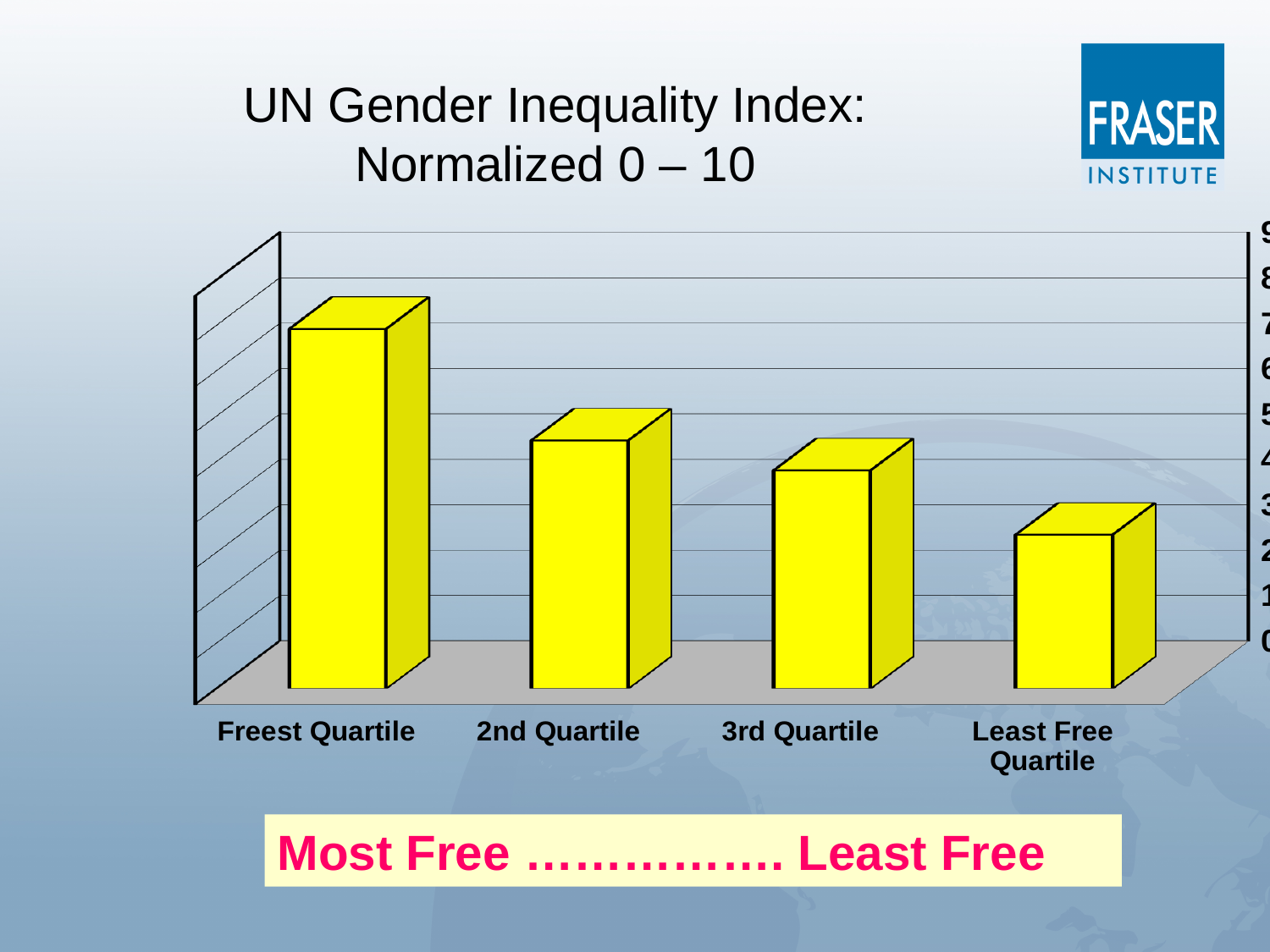
Do the values rise or fall moving from the Freest Quartile to the Least Free Quartile? fall Is the value for the 3rd Quartile greater or less than 3? greater Is the value for the Freest Quartile greater or less than 6? greater What is the title of the chart? UN Gender Inequality Index: Normalized 0 – 10 Which category has the lowest value? Least Free Quartile Which category has the highest value? Freest Quartile Which is larger, the value for the 2nd Quartile or the 3rd Quartile? 2nd Quartile What kind of chart is shown on the slide? bar chart How many categories are plotted in the chart? 4